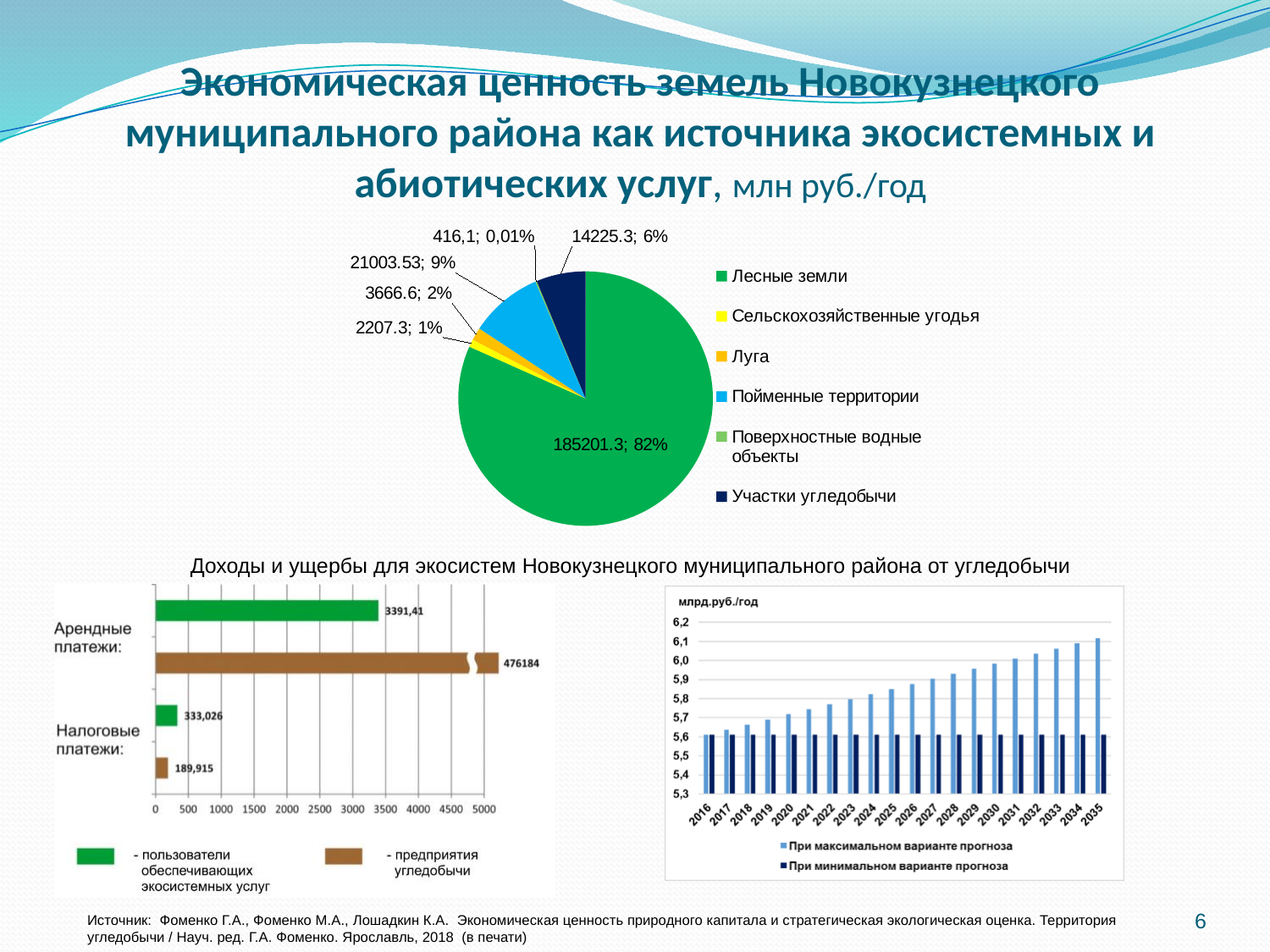
In the bottom-right bar chart, how many years are shown on the x axis? 20 In the top pie chart, what share does Участки угледобычи have? 6% In the top pie chart, what value and share are shown for Лесные земли? 185201.3; 82% In the top pie chart, which category has the smallest slice? Поверхностные водные объекты In the bottom-left bar chart, which bar is the longest? Арендные платежи, предприятия угледобычи (476184) In the bottom-right bar chart, do the values for При максимальном варианте прогноза rise or fall from 2016 to 2035? rise How many categories does the legend of the top pie chart list? 6 In the bottom-left bar chart, what is the value of the brown bar for Налоговые платежи? 189,915 In the top pie chart, which is larger: Пойменные территории or Луга? Пойменные территории In the bottom-left bar chart, what is the value of the green bar for Арендные платежи? 3391,41 What kind of chart is the top chart on the slide? pie chart In the top pie chart, which category has the largest slice? Лесные земли